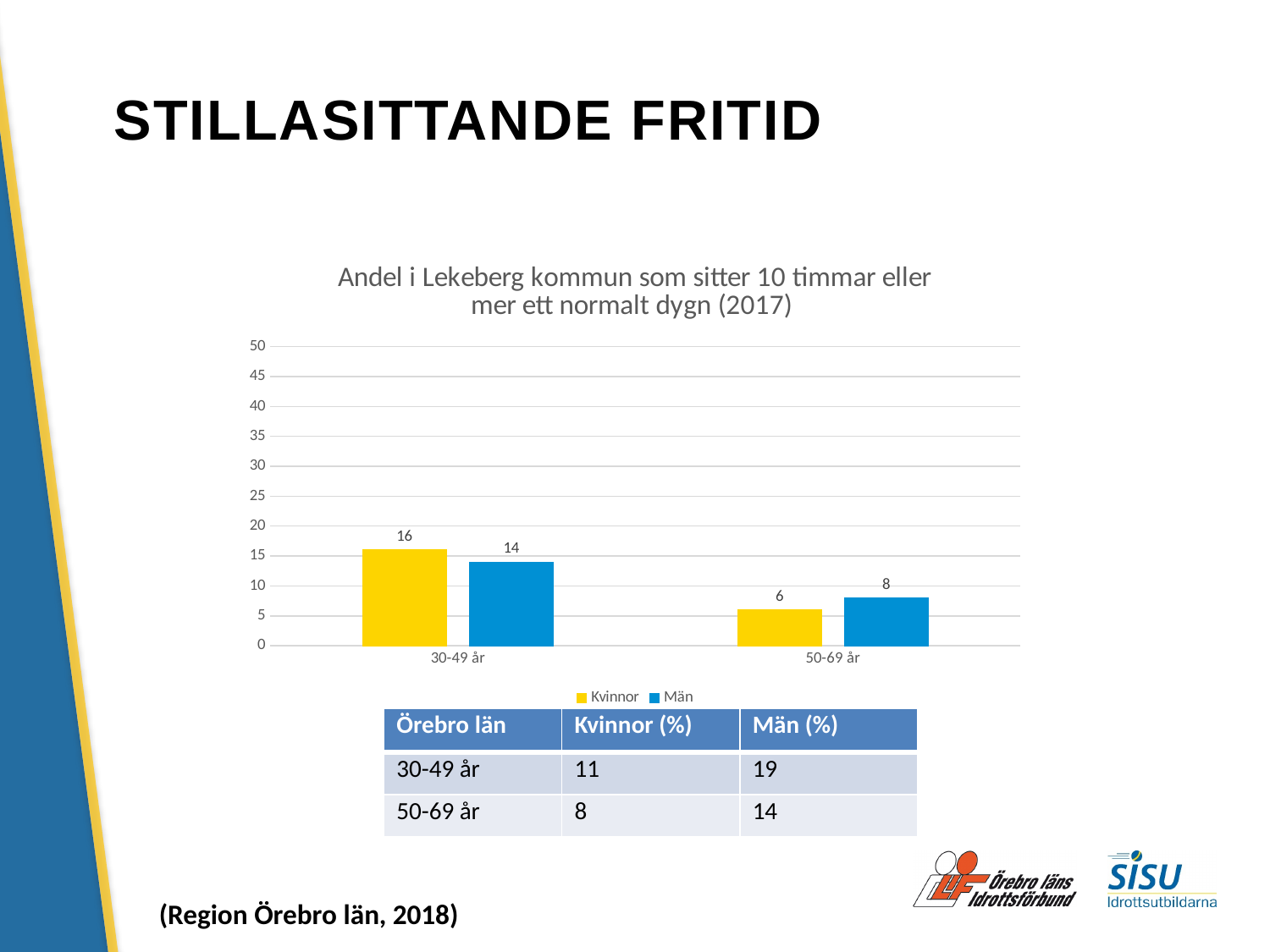
How many age categories are shown on the x axis? 2 What is the value for Kvinnor in the 50-69 år category? 6 How many series does the legend list? 2 Which age group has the lowest value for Kvinnor? 50-69 år What is the value for Kvinnor in the 30-49 år category? 16 In the 50-69 år category, which series has the larger value, Kvinnor or Män? Män What is the title of the chart? Andel i Lekeberg kommun som sitter 10 timmar eller mer ett normalt dygn (2017) What is the difference between the Kvinnor and Män values in the 30-49 år category? 2 What kind of chart is shown on the slide? bar chart What is the value for Män in the 50-69 år category? 8 Which age group has the highest value for Män? 30-49 år Is the value for Kvinnor in the 30-49 år category greater or less than 20? less